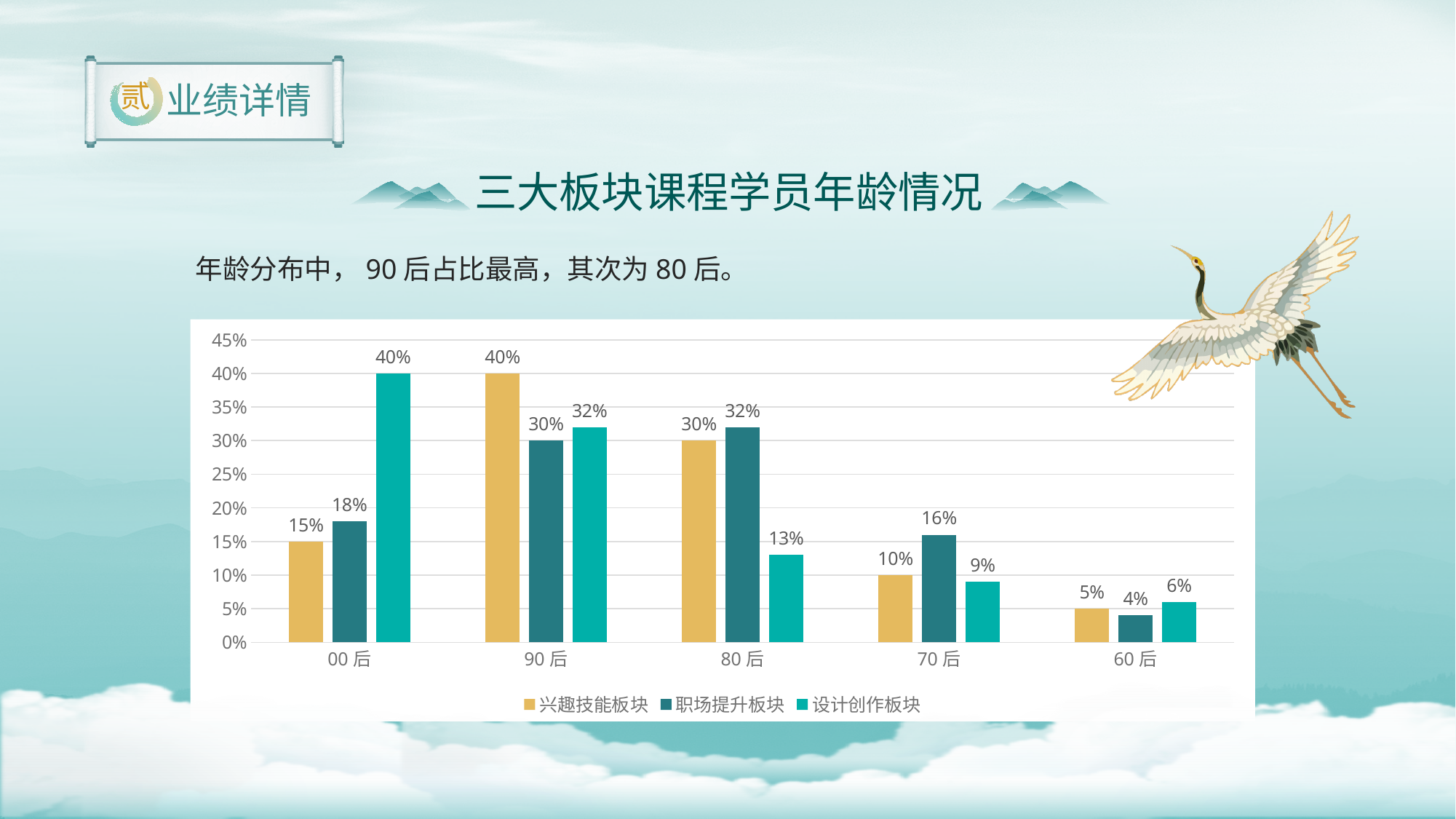
What kind of chart is shown on the slide? Bar chart What is the value for 兴趣技能板块 in the 80 后 category? 30% What is the title of the chart? 三大板块课程学员年龄情况 How many series does the legend list? 3 What is the value for 职场提升板块 in the 70 后 category? 16% Which is larger: 职场提升板块 in 90 后 or 设计创作板块 in 90 后? 设计创作板块 in 90 后 What is the difference between 设计创作板块 in 00 后 and 设计创作板块 in 80 后? 27% Which category has the highest value for 兴趣技能板块? 90 后 What is the value for 设计创作板块 in the 00 后 category? 40% How many age categories are shown on the x axis? 5 Does the value for 设计创作板块 rise or fall from 80 后 to 60 后? Fall Which category has the lowest value for 职场提升板块? 60 后